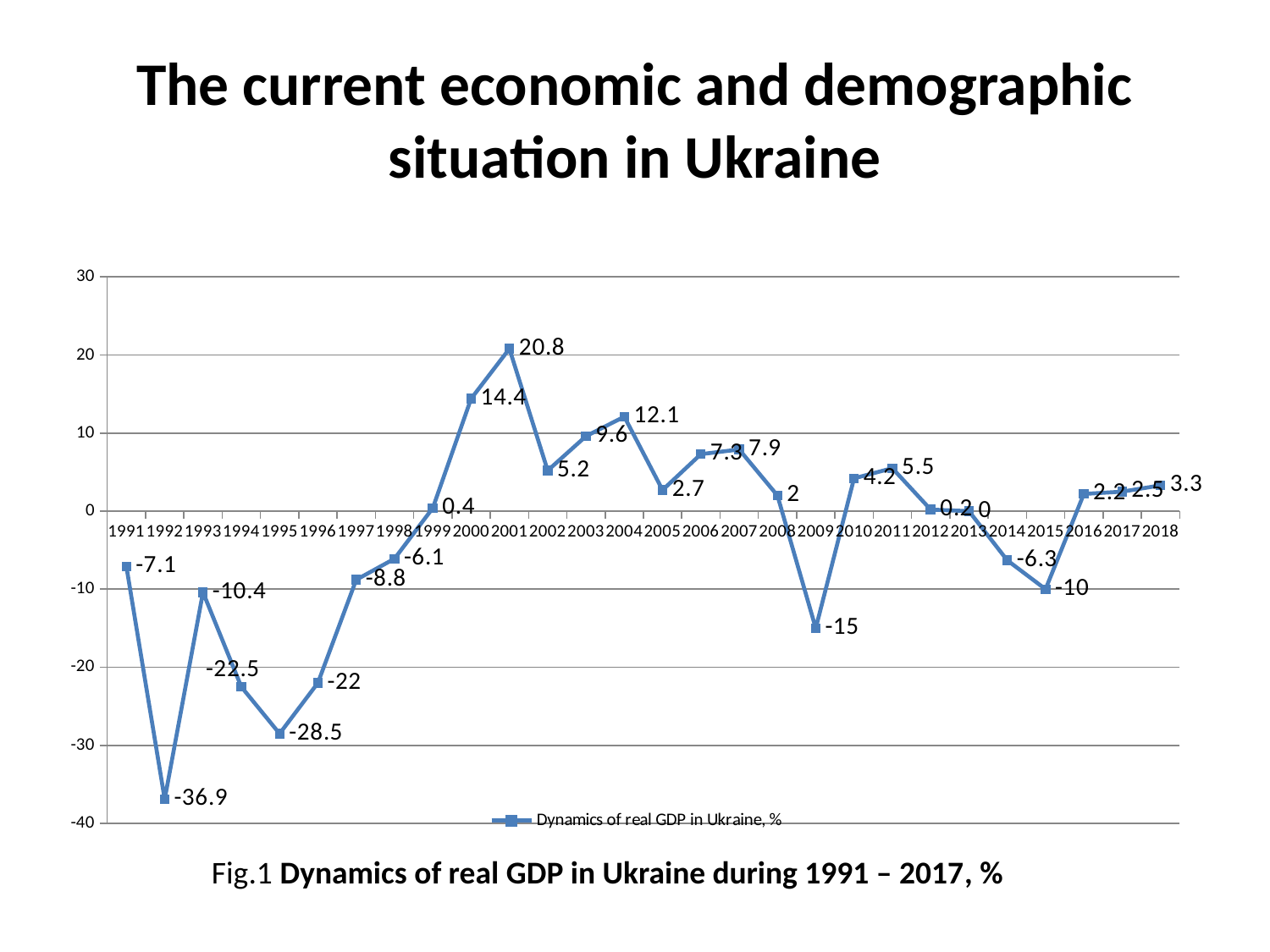
What is the value for 1992? -36.9 What is the value for 2009? -15 What is the difference between the values for 2001 and 2000? 6.4 What kind of chart is shown? line chart How many years are plotted on the chart? 28 What is the value for 2001? 20.8 Is the value for 1995 greater or less than -20? less Which year has the highest value? 2001 What series name does the legend show? Dynamics of real GDP in Ukraine, % Which is larger, the value for 2004 or the value for 2003? 2004 What is the value for 2015? -10 Which year has the lowest value? 1992